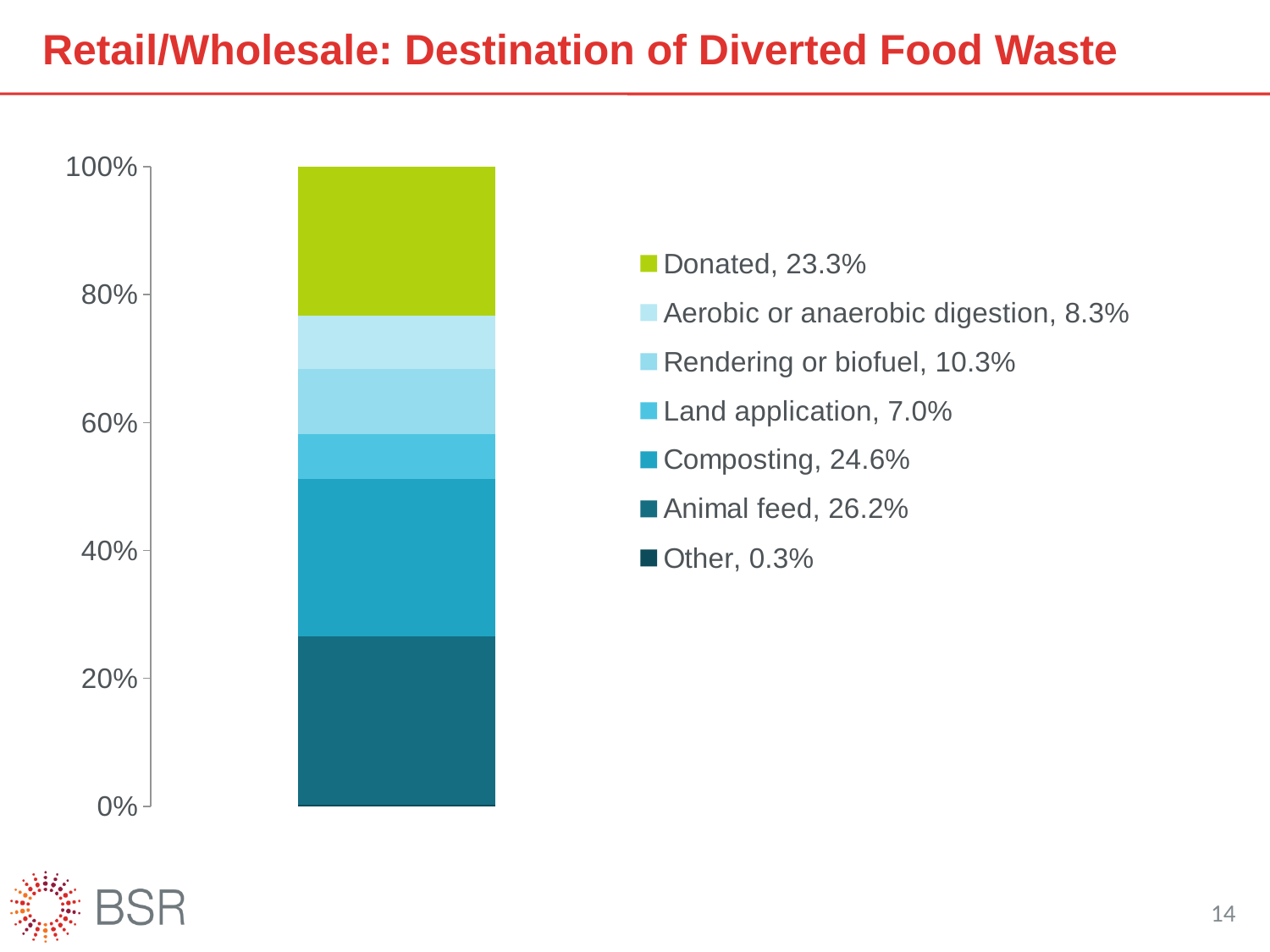
What is the title of the chart? Retail/Wholesale: Destination of Diverted Food Waste What kind of chart is shown on the slide? Stacked bar chart What is the total of all the segments in the stacked bar? 100.0% Which destination has the largest share of diverted food waste? Animal feed Which is larger, the share for Rendering or biofuel or the share for Aerobic or anaerobic digestion? Rendering or biofuel What is the value for Composting? 24.6% What percentage of diverted food waste is donated? 23.3% What is the value for Land application? 7.0% Which destination has the smallest share of diverted food waste? Other What is the difference between the Animal feed share and the Composting share? 1.6% How many series does the legend list? 7 What share of diverted food waste goes to rendering or biofuel? 10.3%